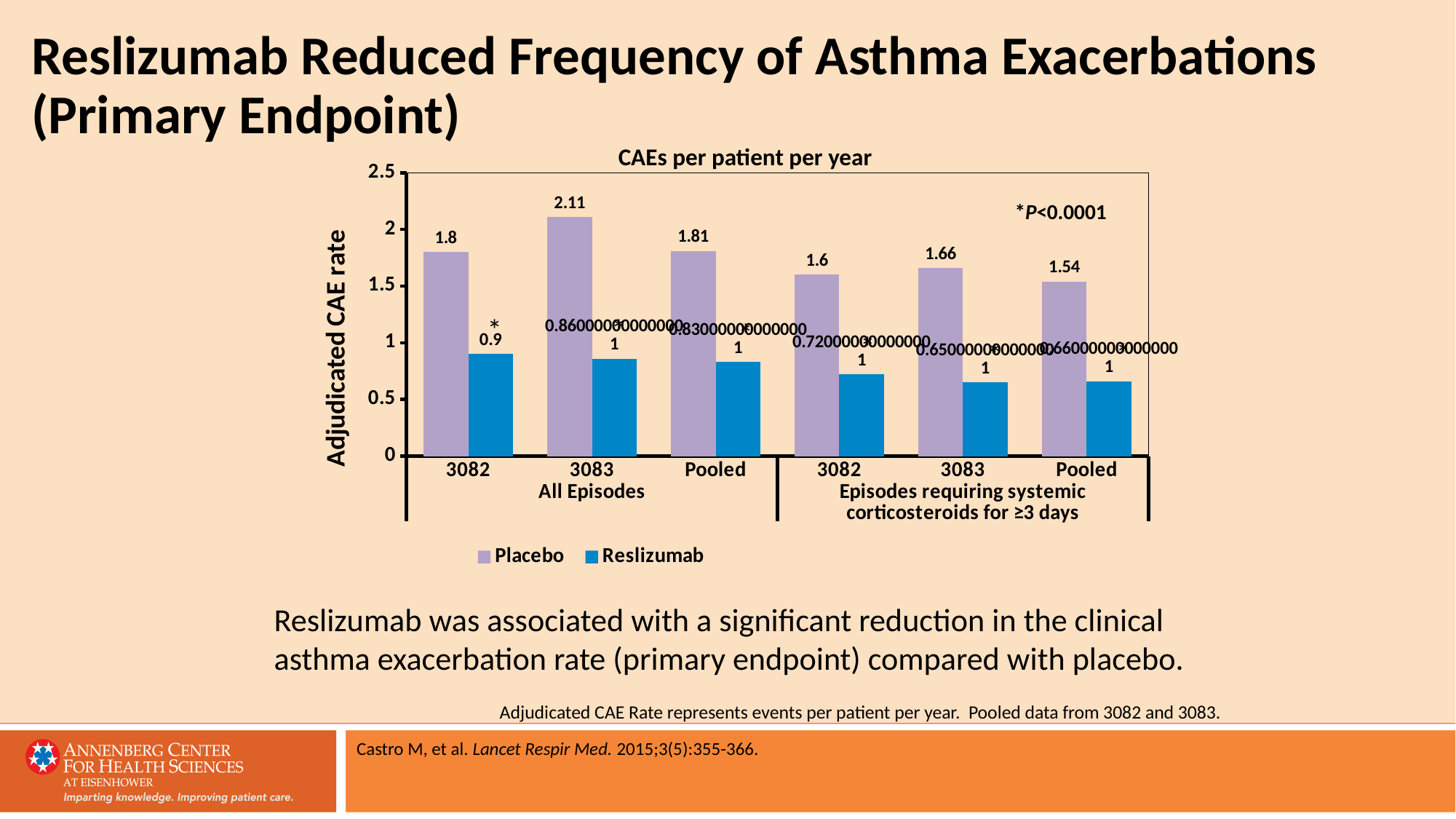
What kind of chart is shown on the slide? Bar chart For study 3082 under All Episodes, which is larger: the Placebo or the Reslizumab value? Placebo Which group has the highest Placebo adjudicated CAE rate? 3083, All Episodes What is the difference between the Placebo values for 3083 and 3082 under All Episodes? 0.31 What is the Reslizumab value for study 3082 under All Episodes? 0.9 What is the Placebo value for study 3082 under All Episodes? 1.8 What is the Placebo value for Pooled under All Episodes? 1.81 What is the Placebo value for study 3083 under All Episodes? 2.11 What is the Placebo value for Pooled under Episodes requiring systemic corticosteroids for ≥3 days? 1.54 Is the Reslizumab value for Pooled under Episodes requiring systemic corticosteroids for ≥3 days greater or less than 1? less What is the Placebo value for study 3082 under Episodes requiring systemic corticosteroids for ≥3 days? 1.6 How many series does the legend list? 2